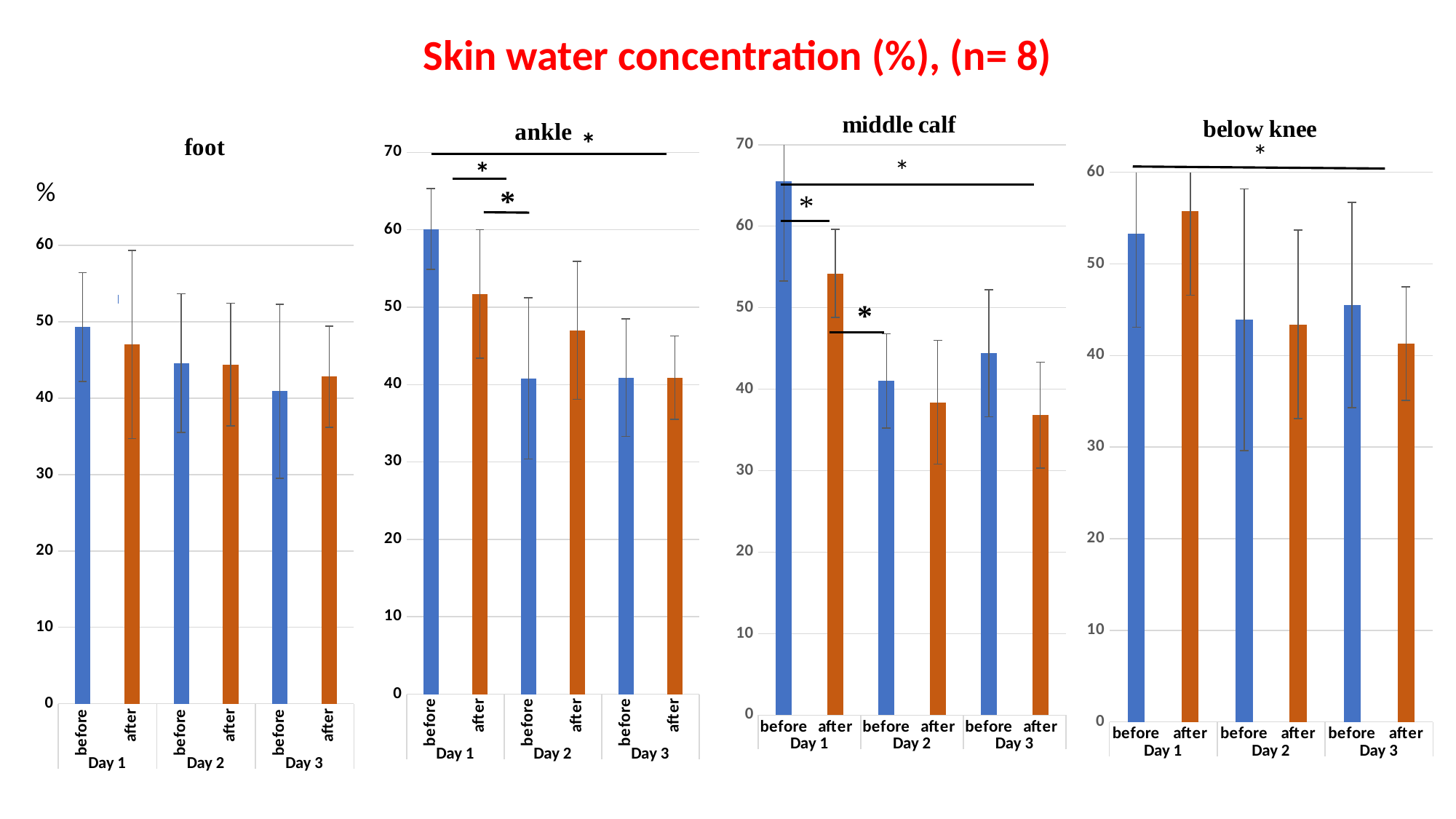
In the "ankle" chart, is the value for Day 1 before greater or less than 50? greater In the "middle calf" chart, is the value for Day 3 after greater or less than 40? less In the "foot" chart, do the "before" values rise or fall from Day 1 to Day 3? fall What kind of chart is the "foot" chart? bar chart In the "below knee" chart, which is larger, Day 1 before or Day 1 after? Day 1 after In the "below knee" chart, is the value for Day 3 after greater or less than 40? greater In the "middle calf" chart, which is larger, Day 1 before or Day 1 after? Day 1 before In the "ankle" chart, which bar is the highest? Day 1 before What is the title of the slide above the charts? Skin water concentration (%), (n= 8) How many bars are plotted in the "foot" chart? 6 How many charts are shown on the slide? 4